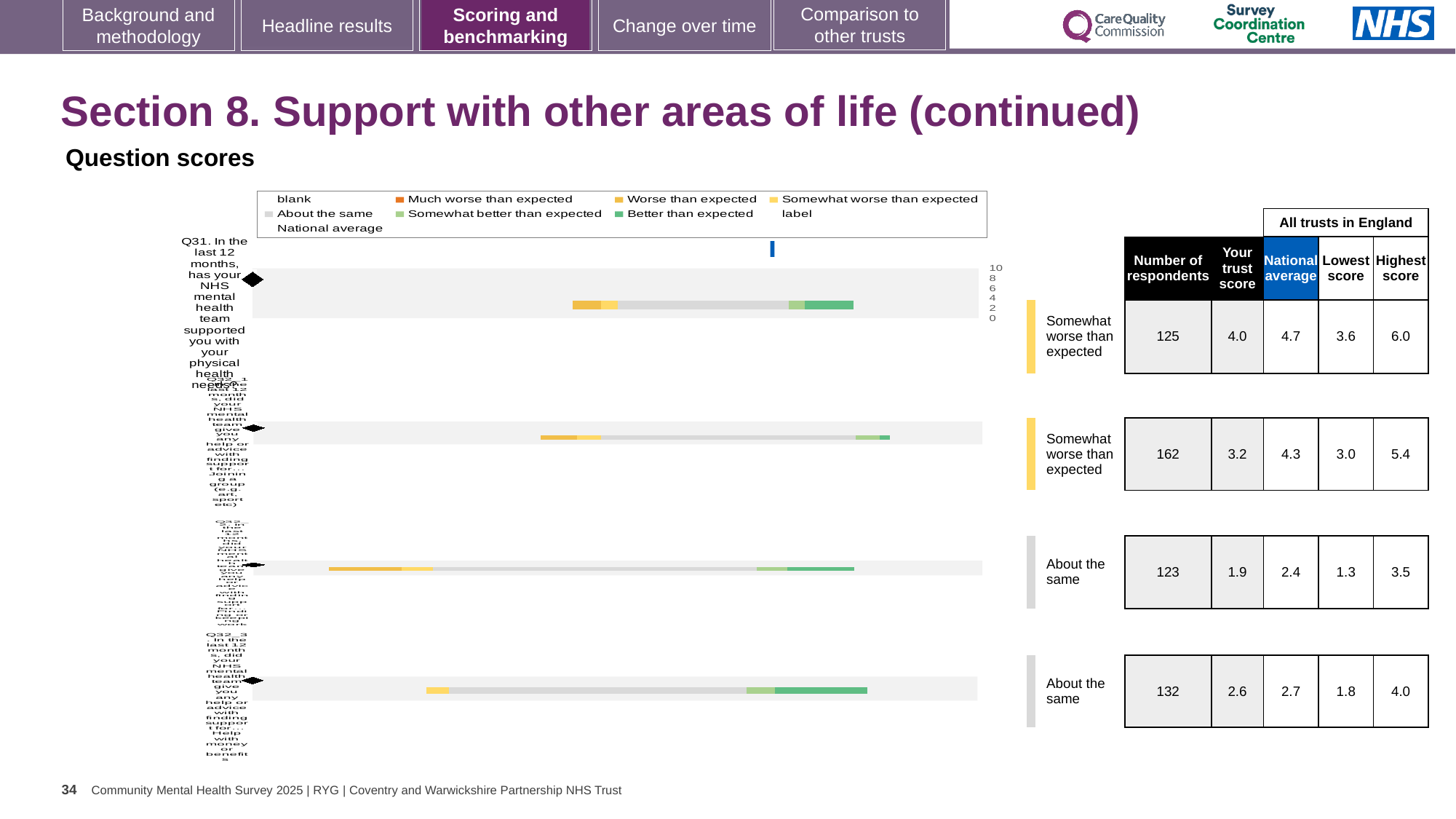
What kind of chart is shown on the slide? bar chart In the top bar (Q31), which segment is the widest? About the same In the second bar (Q32_1), which segment is the widest? About the same What colour represents 'About the same' in the chart legend? grey How many question bars are plotted in the chart? 4 What is the highest tick value shown on the chart's axis? 10 How many entries does the chart legend list? 9 In the top bar (Q31), is the grey 'About the same' segment wider or narrower than the green 'Better than expected' segment? wider